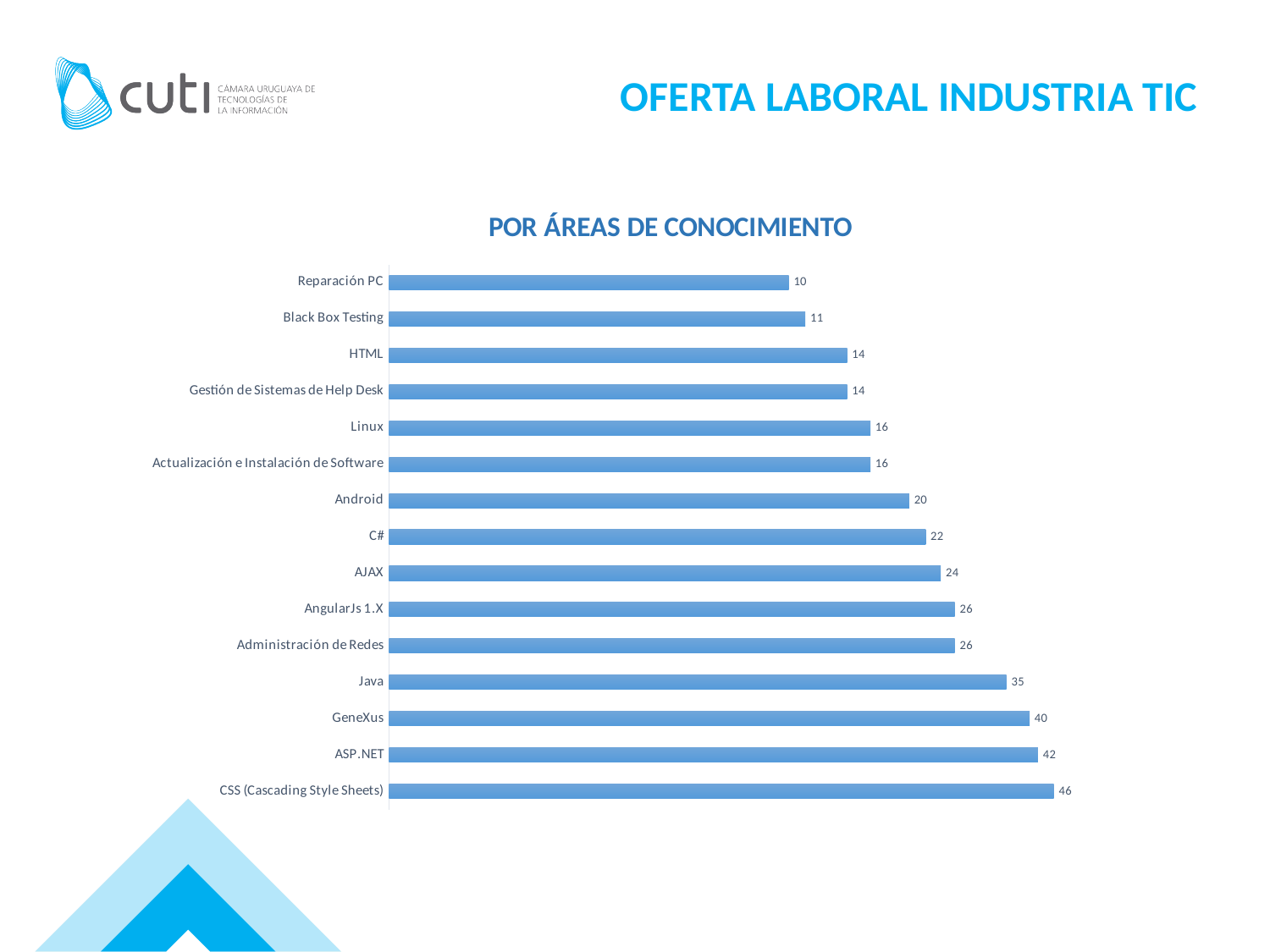
Which category has the highest value? CSS (Cascading Style Sheets) What is the difference between the values for ASP.NET and Java? 7 What is the value for Java? 35 What is the difference between the values for CSS (Cascading Style Sheets) and Reparación PC? 36 What is the value for Android? 20 What is the value for GeneXus? 40 Which category has the lowest value? Reparación PC How many categories are shown in the chart? 15 Which is larger, the value for Linux or the value for Black Box Testing? Linux Which is larger, the value for C# or the value for AJAX? AJAX What kind of chart is shown on the slide? Bar chart What is the title of the chart? POR ÁREAS DE CONOCIMIENTO